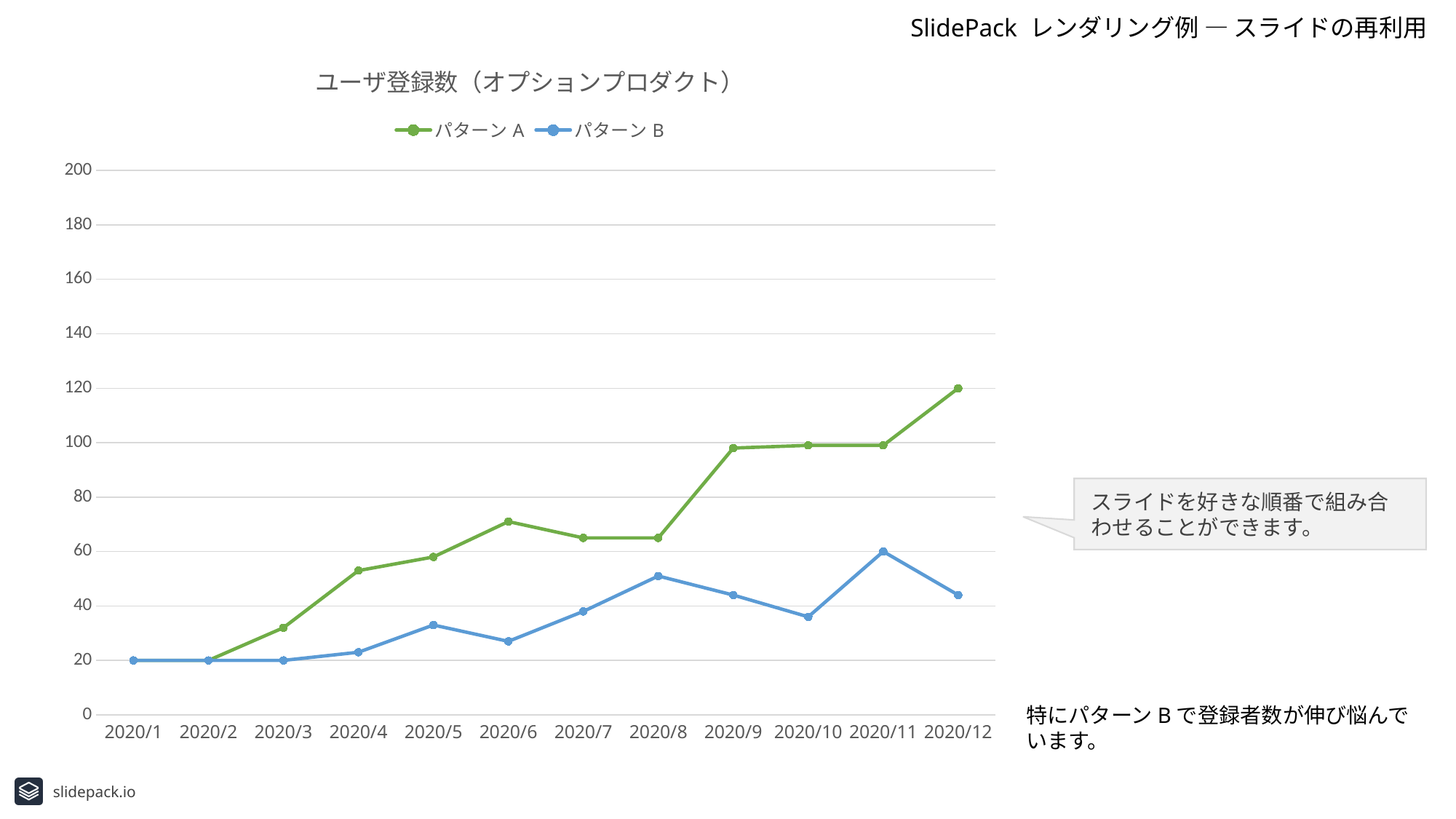
In which month does パターン B reach its highest value? 2020/11 Is the value for パターン B in 2020/10 greater or less than 40? less What is the value for パターン B in 2020/11? 60 In which month does パターン A reach its highest value? 2020/12 Which series has the larger value in 2020/6, パターン A or パターン B? パターン A What is the title of the chart? ユーザ登録数（オプションプロダクト） Is the value for パターン A in 2020/9 greater or less than 80? greater How many series does the legend list? 2 What is the value for パターン A in 2020/1? 20 What is the value for パターン A in 2020/12? 120 What kind of chart is shown on the slide? line chart How many months are plotted along the x axis? 12